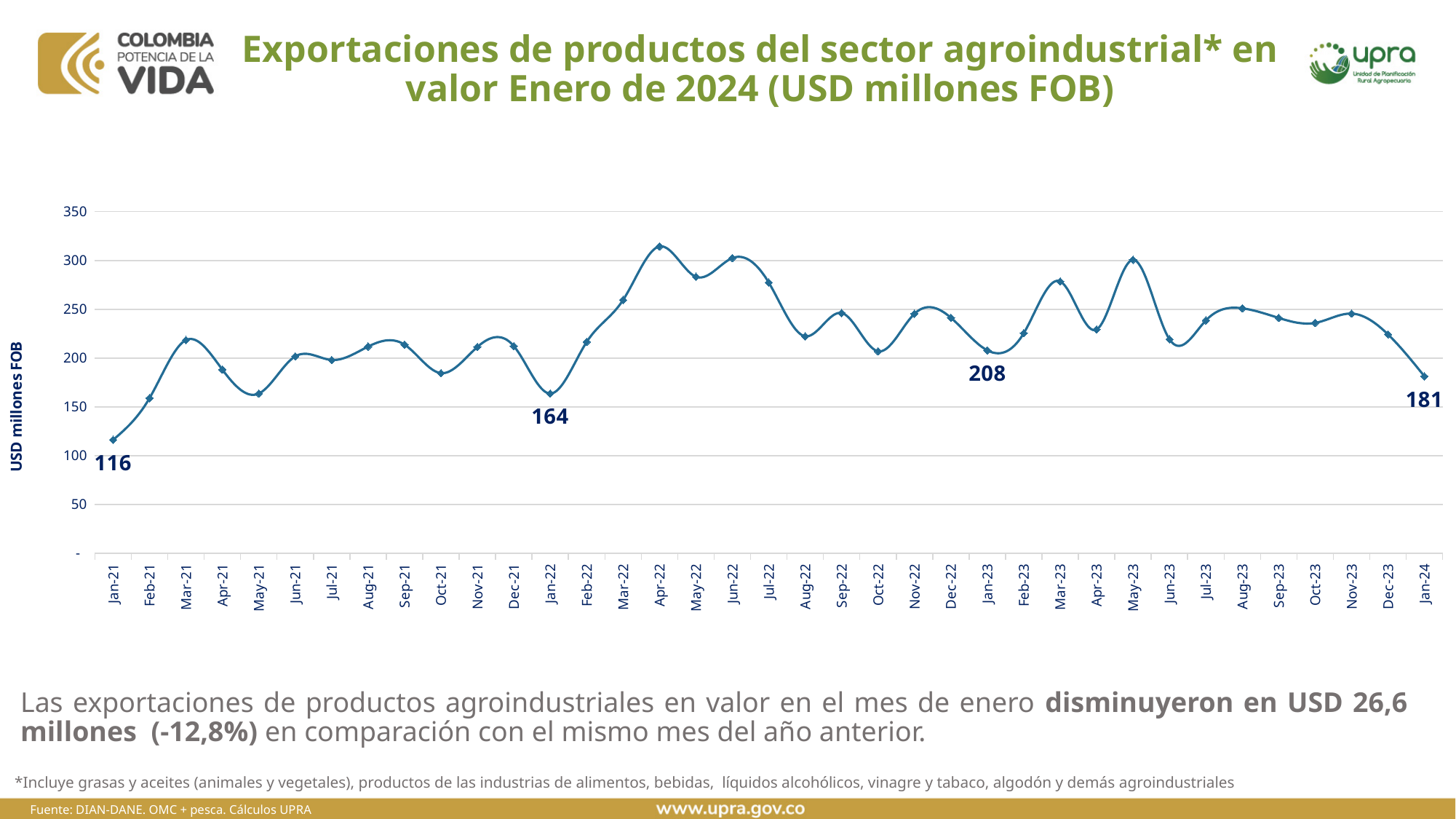
What is the difference between the values for Jan-23 and Jan-24? 27 Which is larger, the value for Jan-21 or the value for Jan-22? Jan-22 What is the value for Jan-23? 208 What is the label on the vertical axis? USD millones FOB What is the value for Jan-24? 181 What is the value for Jan-21? 116 Is the value for Feb-21 greater or less than 200? less What is the value for Jan-22? 164 Which month has the highest value on the chart? Apr-22 Which month has the lowest value on the chart? Jan-21 What type of chart is shown on the slide? Line chart Is the value for Apr-22 greater or less than 300? greater